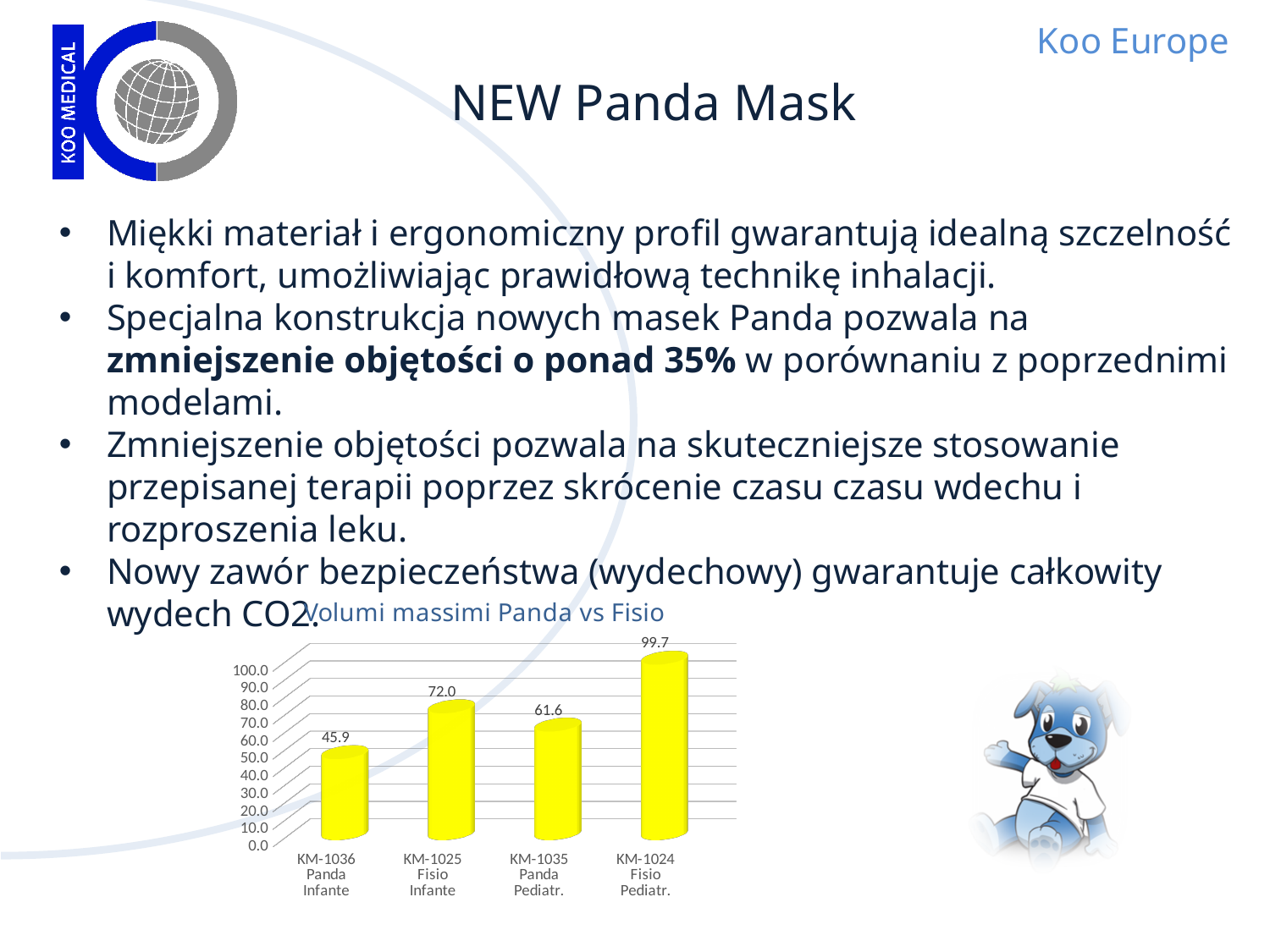
What is the value for KM-1035 Panda Pediatr.? 61.6 Which category has the highest value? KM-1024 Fisio Pediatr. What is the difference between the values for KM-1024 Fisio Pediatr. and KM-1035 Panda Pediatr.? 38.1 How many categories are shown in the chart? 4 What is the title of the chart? Volumi massimi Panda vs Fisio What kind of chart is shown on the slide? Bar chart What is the value for KM-1036 Panda Infante? 45.9 What is the value for KM-1025 Fisio Infante? 72.0 What is the value for KM-1024 Fisio Pediatr.? 99.7 What is the difference between the values for KM-1025 Fisio Infante and KM-1036 Panda Infante? 26.1 Which category has the lowest value? KM-1036 Panda Infante Which is larger, the value for KM-1025 Fisio Infante or KM-1035 Panda Pediatr.? KM-1025 Fisio Infante